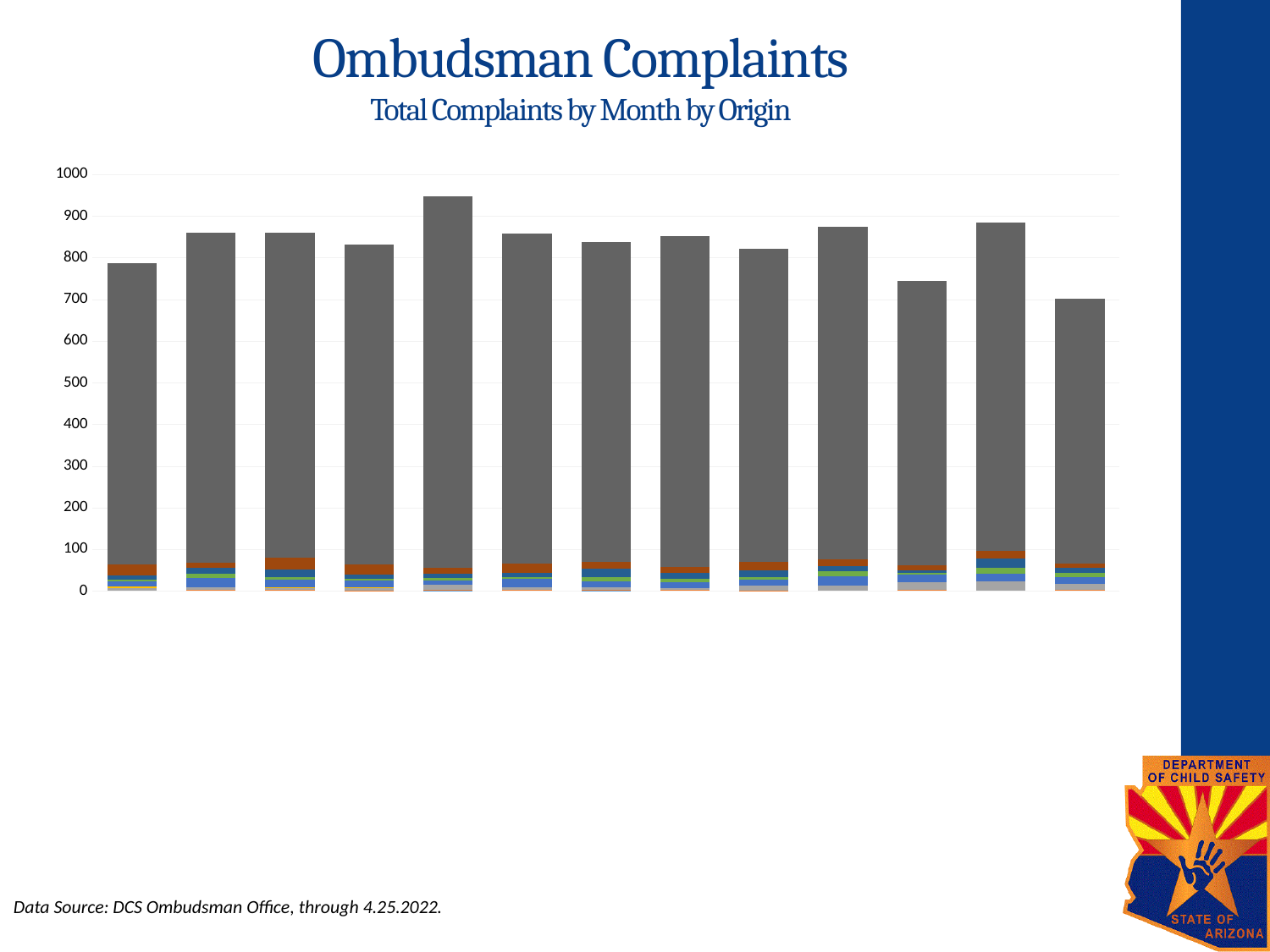
Is the total for the last bar on the right greater or less than 800? less Which bar, counting from the left, is the tallest in the chart? the fifth bar How many bars are plotted in the chart? 13 What is the highest value shown on the vertical axis of the chart? 1000 Is the total for the first bar on the left greater or less than 700? greater What is the title of the chart on the slide? Ombudsman Complaints Is the total for the fifth bar from the left greater or less than 900? greater Which bar, counting from the left, is the shortest in the chart? the last (thirteenth) bar Do the bar totals rise or fall from the twelfth bar to the thirteenth bar? fall Which is taller, the twelfth bar from the left or the eleventh bar from the left? the twelfth bar What kind of chart is shown on the slide? bar chart